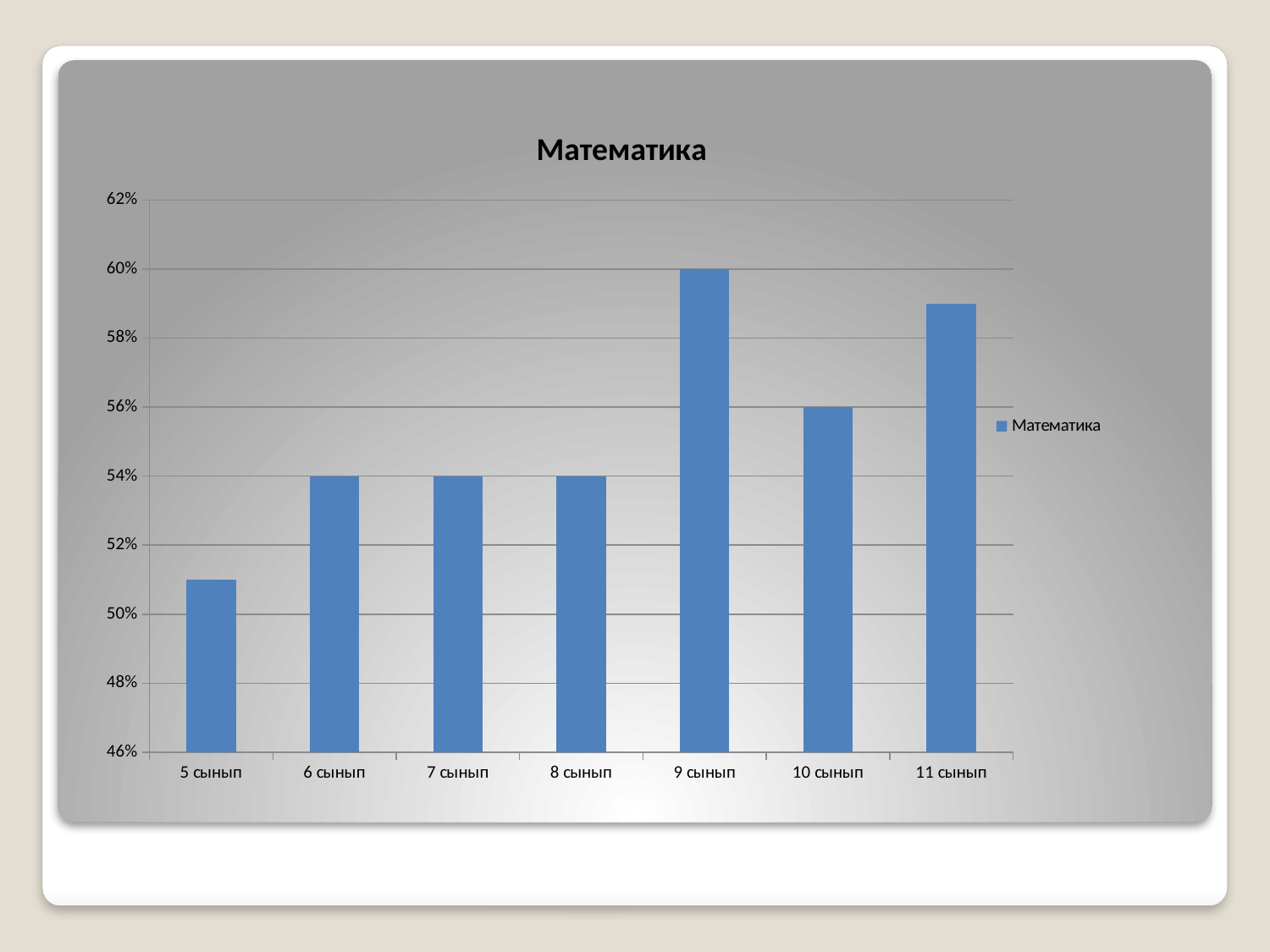
How many series does the legend list? 1 Which category has the lowest value? 5 сынып Which category has the highest value? 9 сынып What is the title of the chart? Математика What kind of chart is shown on the slide? bar chart What is the value for 9 сынып? 60% What is the value for 10 сынып? 56% What is the value for 6 сынып? 54% Which is larger, the value for 10 сынып or the value for 8 сынып? 10 сынып Is the value for 5 сынып greater or less than 52%? less How many categories are shown on the x axis? 7 Is the value for 11 сынып greater or less than 58%? greater